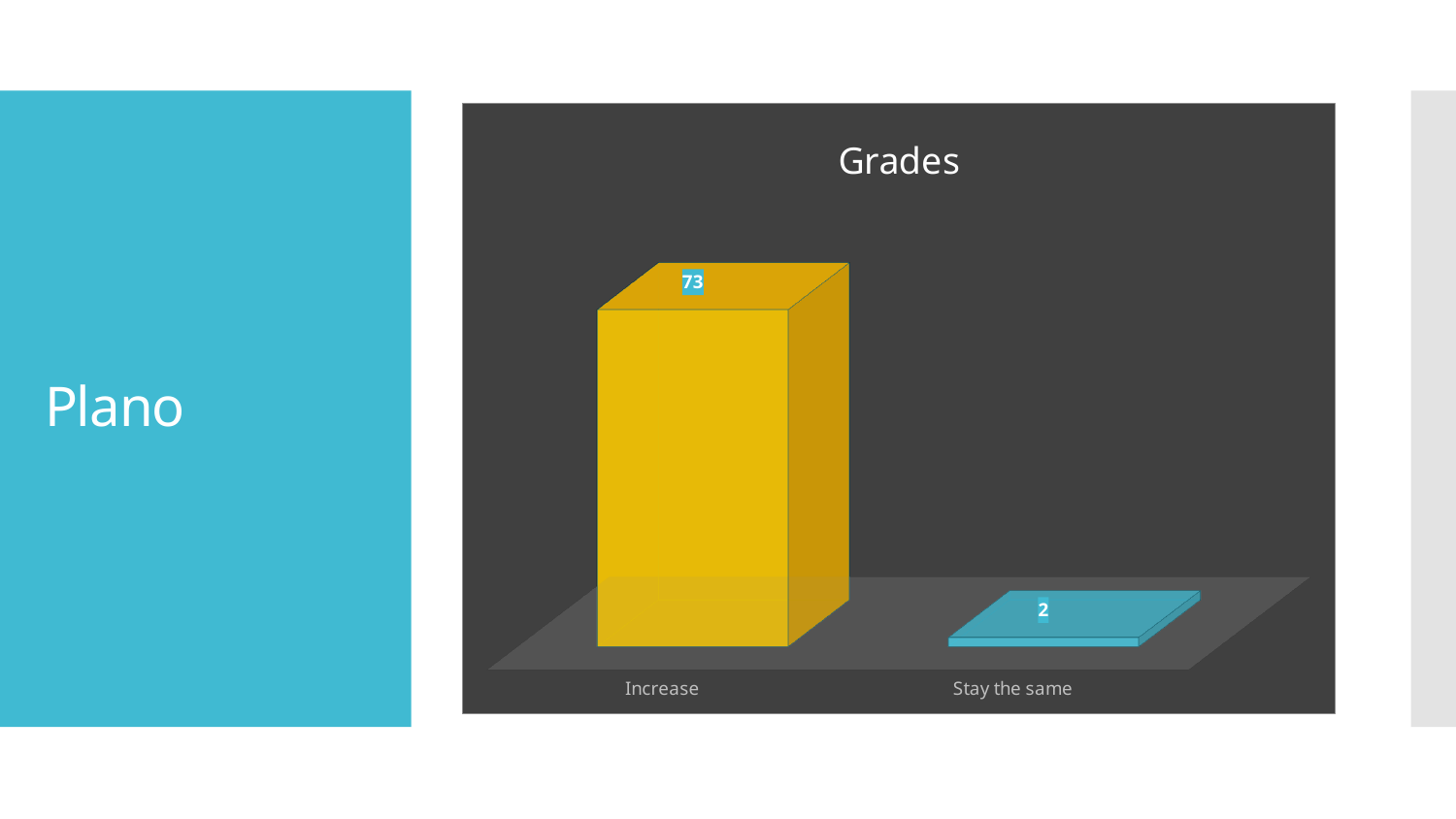
What is the title of the chart? Grades What kind of chart is shown on the slide? Bar chart How many categories are shown in the chart? 2 Which category has the lowest value? Stay the same Which is larger, the value for Increase or the value for Stay the same? Increase What colour is the bar for Increase? Yellow Which category has the highest value? Increase What is the value for Stay the same? 2 What is the total of the values for Increase and Stay the same? 75 What is the difference between the values for Increase and Stay the same? 71 What is the value for Increase? 73